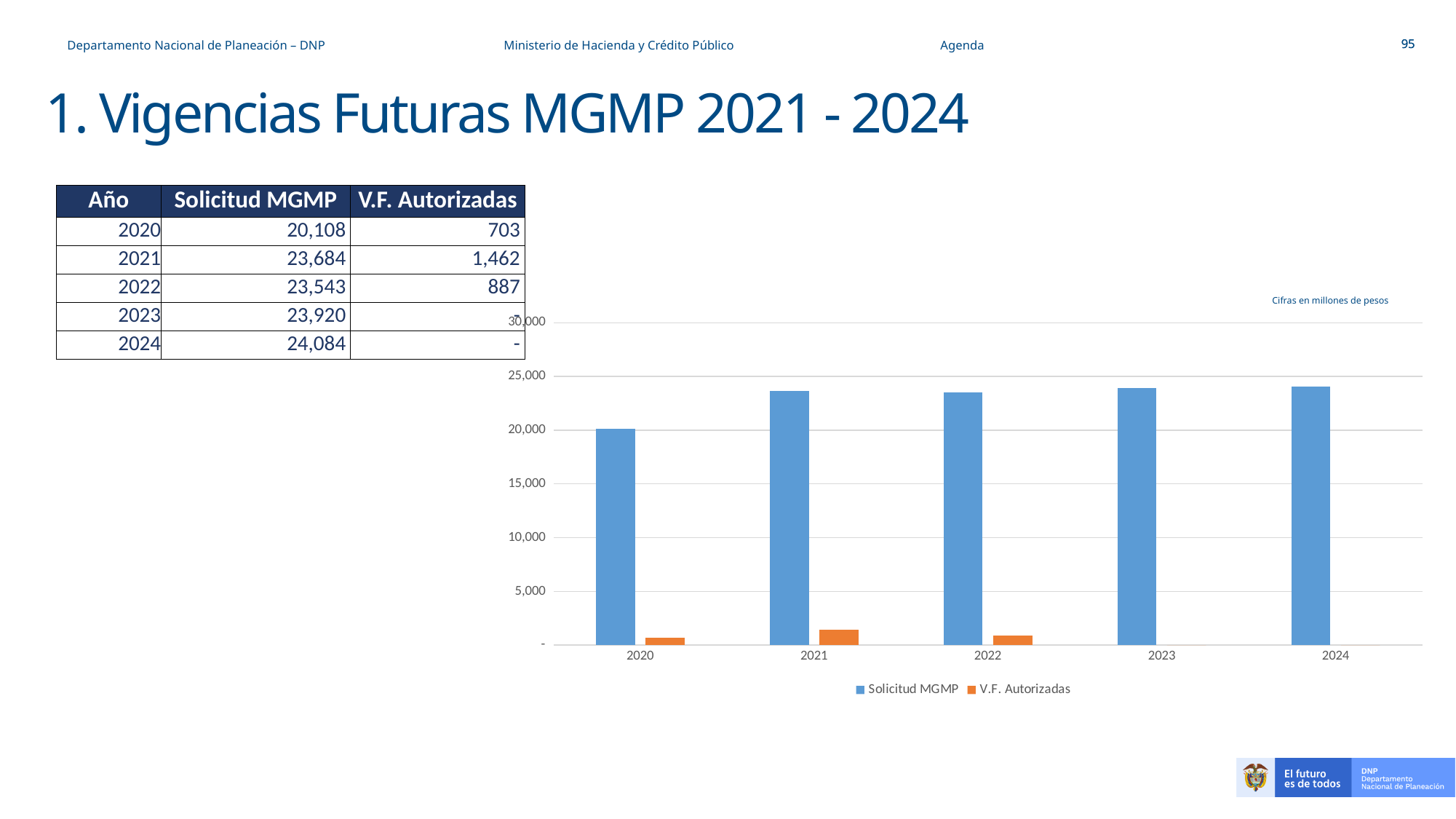
Which colour represents the V.F. Autorizadas series in the chart? orange Which year has the lowest Solicitud MGMP value? 2020 What is the V.F. Autorizadas value for 2021? 1,462 How many years are shown on the x axis of the chart? 5 Which year has the highest Solicitud MGMP value? 2024 What is the difference between the Solicitud MGMP values for 2024 and 2020? 3,976 Which is larger, the V.F. Autorizadas value for 2020 or for 2022? 2022 What is the Solicitud MGMP value for 2020? 20,108 Which year has the highest V.F. Autorizadas value? 2021 How many series does the chart legend list? 2 Is the Solicitud MGMP value for 2023 greater or less than 20,000? greater What kind of chart is shown on the slide? bar chart